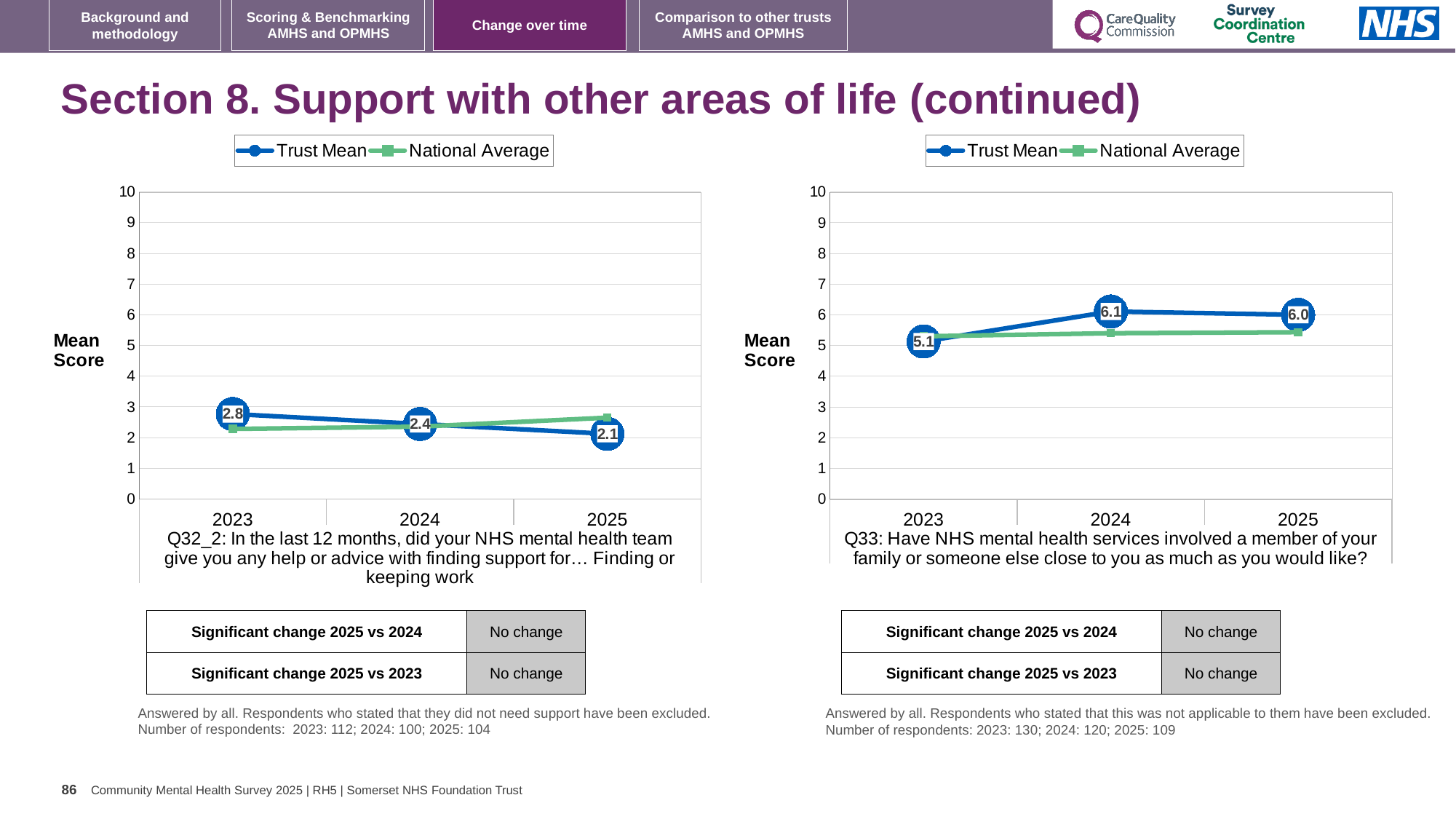
In the left chart (Q32_2), does the Trust Mean rise or fall from 2023 to 2025? fall In the right chart (Q33), which year has the lowest Trust Mean? 2023 In the right chart (Q33), what is the Trust Mean for 2023? 5.1 In the left chart (Q32_2), what is the Trust Mean for 2023? 2.8 In the right chart (Q33), what is the Trust Mean for 2024? 6.1 In the left chart (Q32_2), what is the Trust Mean for 2025? 2.1 In the left chart (Q32_2), is the National Average for 2025 greater or less than 3? less In the right chart (Q33), is the Trust Mean for 2025 greater or less than 5? greater In the left chart (Q32_2), which year has the highest Trust Mean? 2023 In the right chart (Q33), what is the difference between the Trust Mean for 2024 and 2023? 1.0 How many series does the legend of the right chart (Q33) list? 2 In the left chart (Q32_2), what is the difference between the Trust Mean for 2023 and 2025? 0.7